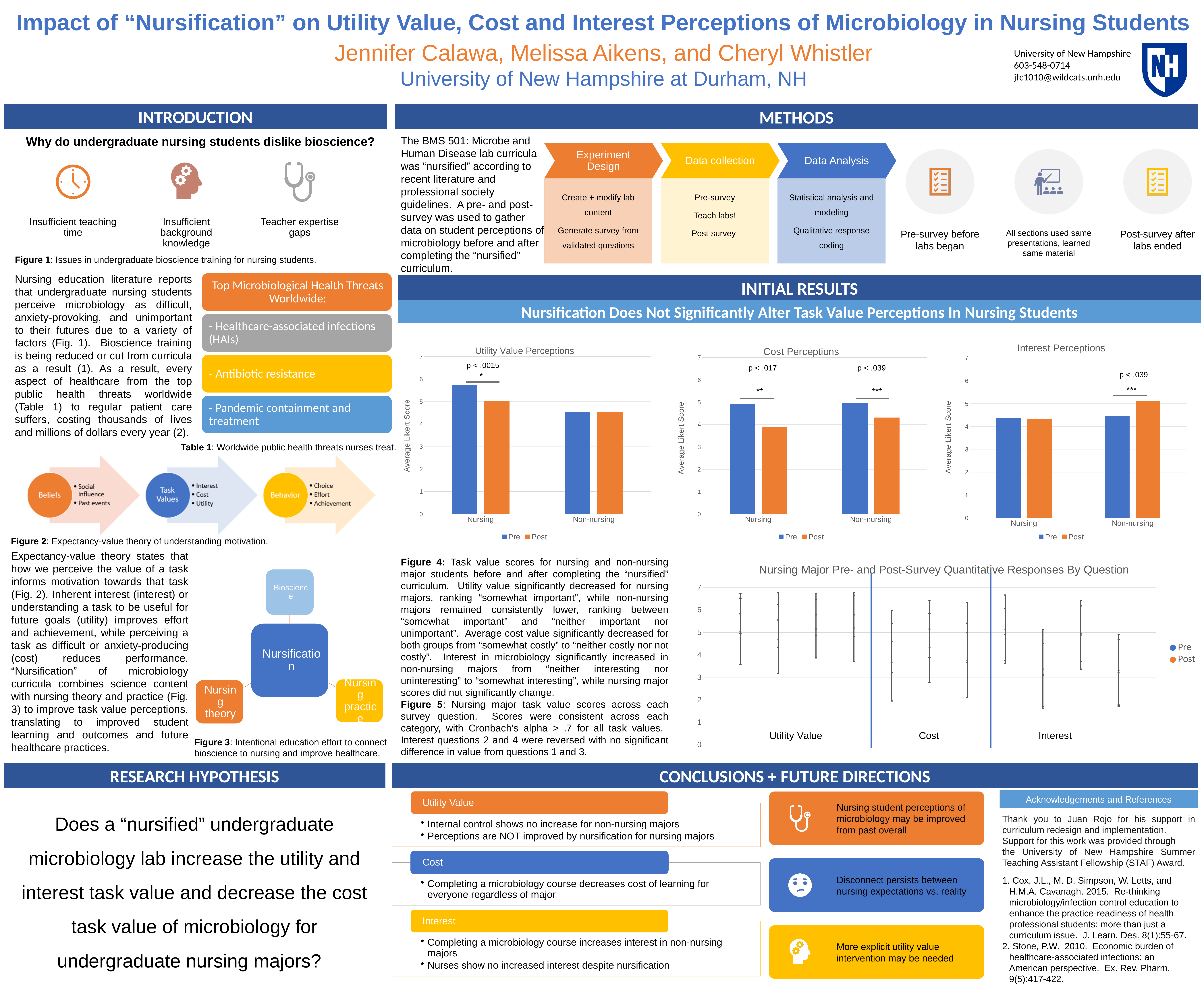
What p-value is annotated above the Nursing bars in the "Utility Value Perceptions" chart? p < .0015 In the "Utility Value Perceptions" chart, is the Post value for Non-nursing greater or less than 5? less How many categories are shown on the x axis of the "Interest Perceptions" chart? 2 How many series does the legend of the "Cost Perceptions" chart list? 2 In the "Utility Value Perceptions" chart, which is larger for Nursing: the Pre bar or the Post bar? Pre In the "Utility Value Perceptions" chart, is the Pre value for Nursing greater or less than 5? greater In the "Cost Perceptions" chart, which bar is the lowest? Nursing Post What kind of chart is the "Utility Value Perceptions" chart? bar chart What are the two legend entries in the "Cost Perceptions" chart? Pre and Post In the "Interest Perceptions" chart, which bar is the highest? Non-nursing Post In the "Interest Perceptions" chart, which is larger for Non-nursing: the Pre bar or the Post bar? Post In the "Cost Perceptions" chart, is the Post value for Nursing greater or less than 5? less